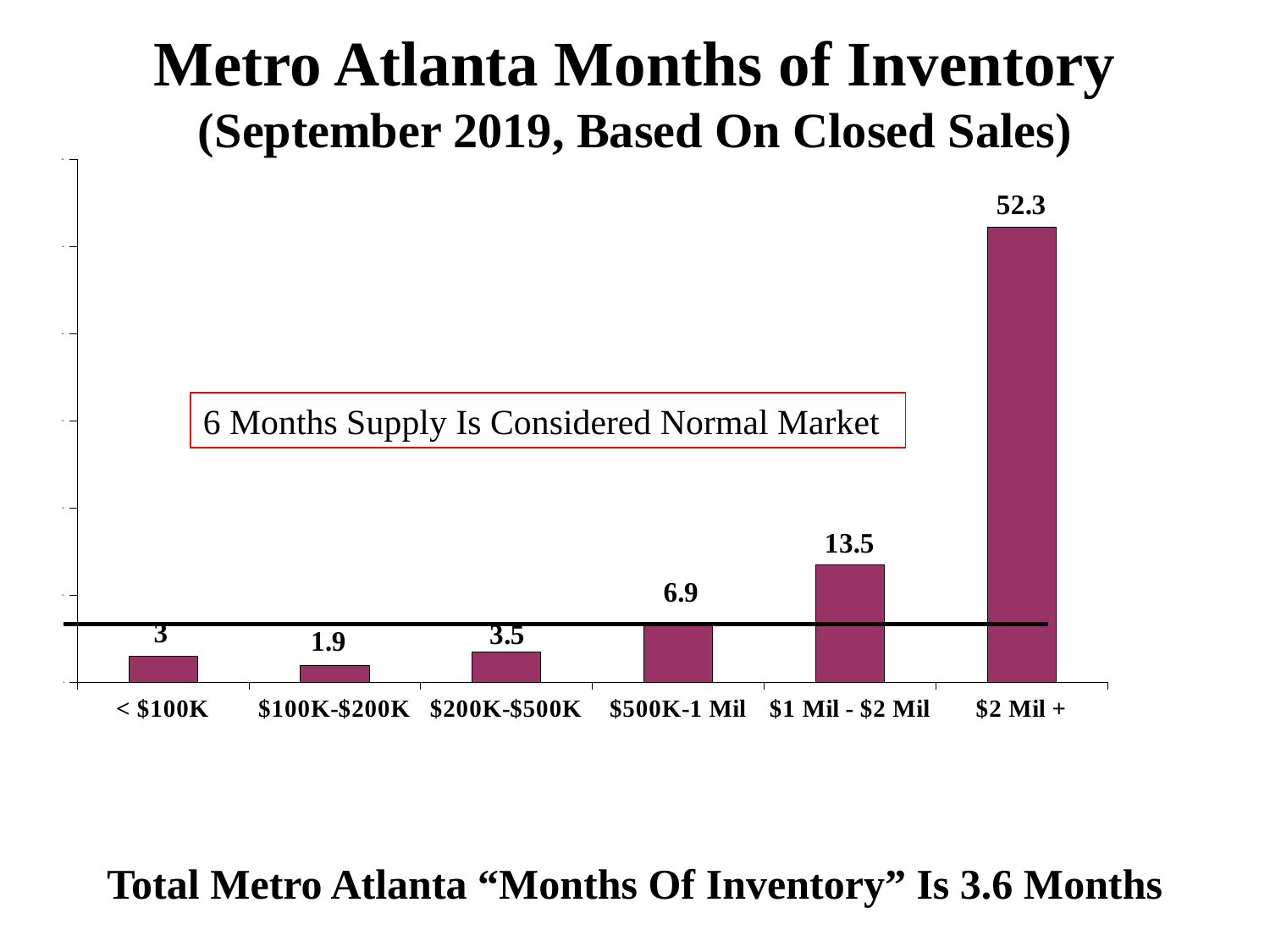
What is the months of inventory value for the $1 Mil - $2 Mil price range? 13.5 How many price range categories are shown on the chart? 6 What is the difference in months of inventory between the $2 Mil + and $1 Mil - $2 Mil price ranges? 38.8 What is the months of inventory value for the $500K-1 Mil price range? 6.9 What is the difference in months of inventory between the $200K-$500K and < $100K price ranges? 0.5 Which price range has the lowest months of inventory? $100K-$200K Which price range has the highest months of inventory? $2 Mil + Which has a larger months of inventory value, $500K-1 Mil or $200K-$500K? $500K-1 Mil What type of chart is shown on the slide? Bar chart According to the text box on the chart, how many months of supply is considered a normal market? 6 months What is the months of inventory value for the $2 Mil + price range? 52.3 What is the months of inventory value for the $100K-$200K price range? 1.9